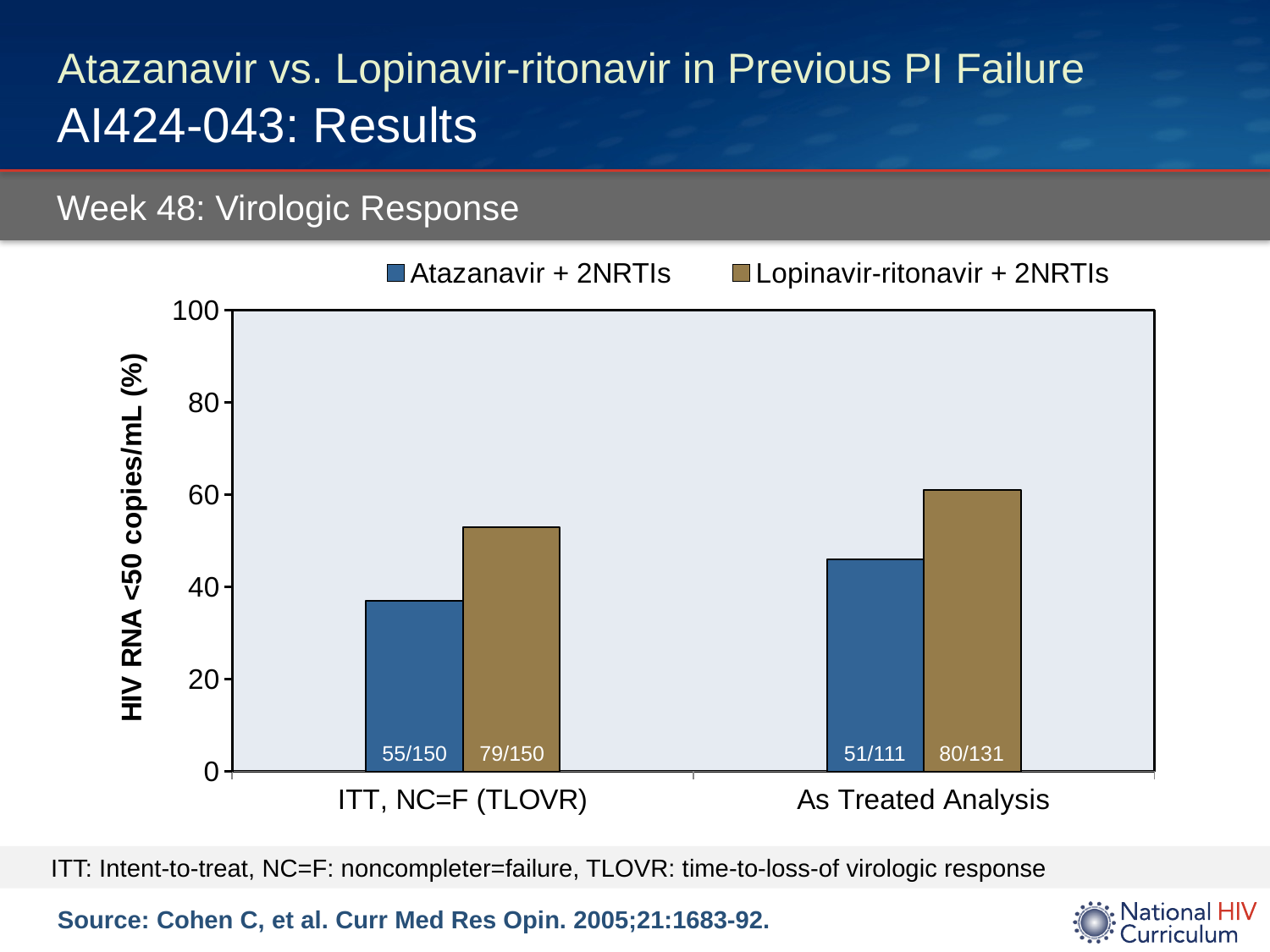
What kind of chart is shown on the slide? bar chart Which series has the larger value for As Treated Analysis, Atazanavir + 2NRTIs or Lopinavir-ritonavir + 2NRTIs? Lopinavir-ritonavir + 2NRTIs What label is printed on the Atazanavir + 2NRTIs bar for As Treated Analysis? 51/111 What label is printed on the Atazanavir + 2NRTIs bar for ITT, NC=F (TLOVR)? 55/150 Is the value for Atazanavir + 2NRTIs in ITT, NC=F (TLOVR) greater or less than 40? less What is the y-axis label of the chart? HIV RNA <50 copies/mL (%) How many series does the legend list? 2 What label is printed on the Lopinavir-ritonavir + 2NRTIs bar for ITT, NC=F (TLOVR)? 79/150 What label is printed on the Lopinavir-ritonavir + 2NRTIs bar for As Treated Analysis? 80/131 Which bar is the tallest in the chart? Lopinavir-ritonavir + 2NRTIs, As Treated Analysis How many categories are shown on the x axis? 2 Is the value for Lopinavir-ritonavir + 2NRTIs in As Treated Analysis greater or less than 50? greater